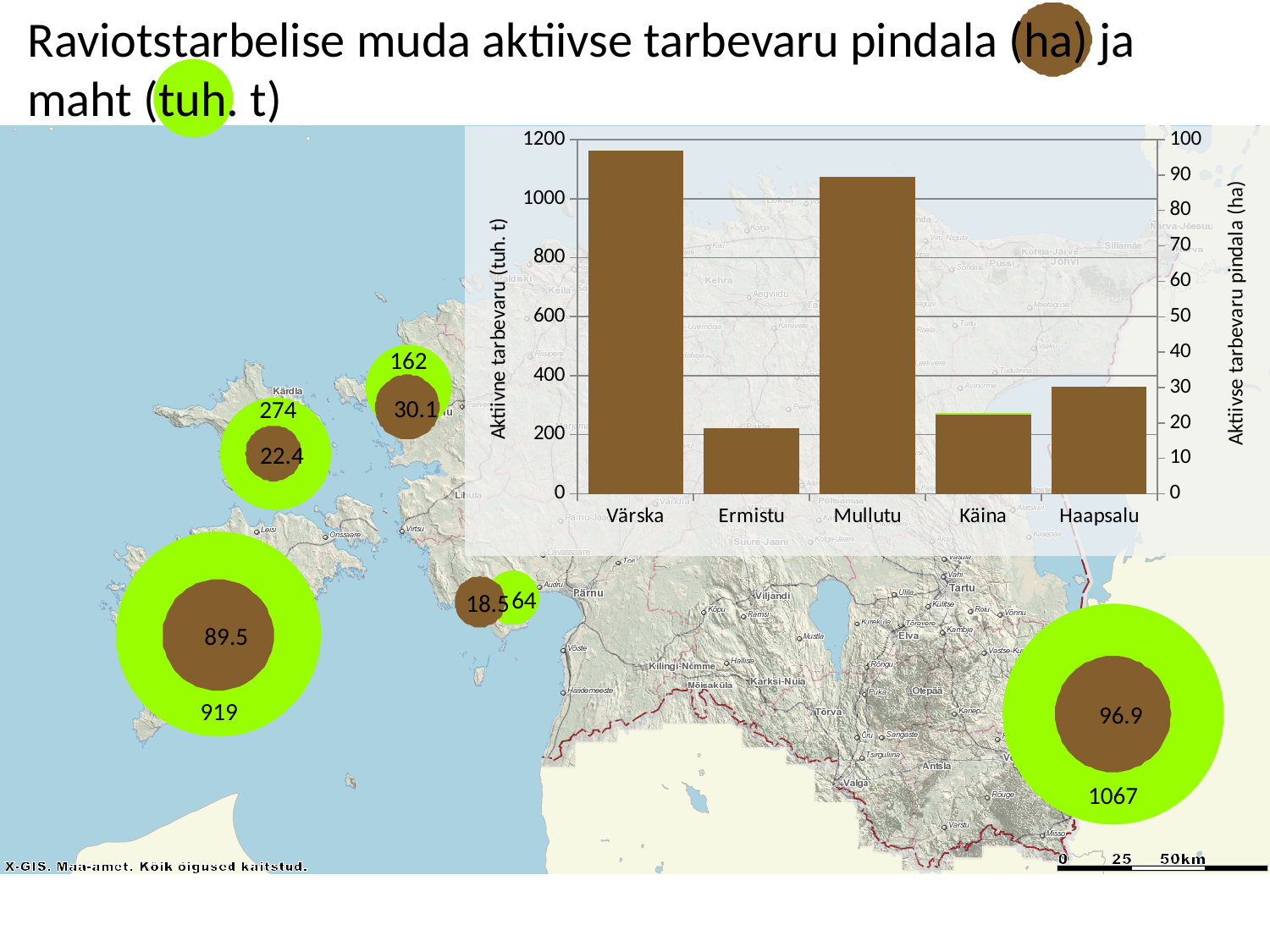
What is the label of the right vertical axis of the bar chart? Aktiivse tarbevaru pindala (ha) Which category has the tallest bar in the bar chart? Värska What kind of chart is shown on the slide? bar chart On the left axis of the bar chart, is the bar for Mullutu greater or less than 800? greater Which category has the shortest bar in the bar chart? Ermistu On the left axis of the bar chart, is the bar for Värska greater or less than 1000? greater What is the label of the left vertical axis of the bar chart? Aktiivne tarbevaru (tuh. t) In the bar chart, is the bar for Mullutu taller or shorter than the bar for Haapsalu? taller How many categories are shown on the x axis of the bar chart? 5 On the left axis of the bar chart, is the bar for Käina greater or less than 400? less In the bar chart, is the bar for Haapsalu taller or shorter than the bar for Ermistu? taller In the bar chart, is the bar for Käina taller or shorter than the bar for Värska? shorter